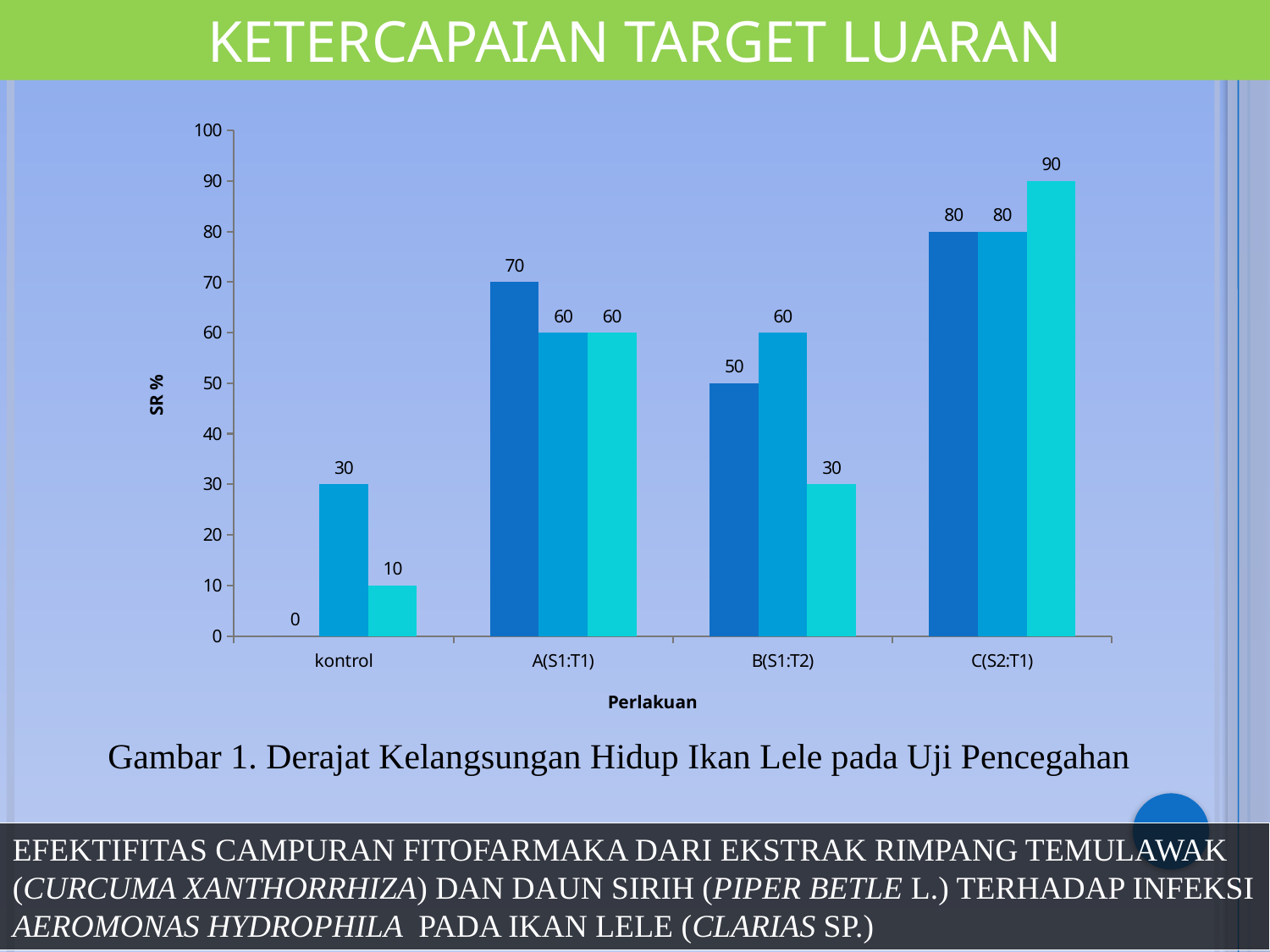
What is the difference between the cyan (third) bar for C(S2:T1) and the cyan (third) bar for B(S1:T2)? 60 What is the value of the cyan (third) bar for C(S2:T1)? 90 What is the value of the dark blue (first) bar for A(S1:T1)? 70 What type of chart is shown on the slide? bar chart What is the value of the medium blue (second) bar for B(S1:T2)? 60 What is the label of the y axis? SR % Which category has the lowest bar in the chart? kontrol Which category has the highest bar in the chart? C(S2:T1) What is the value of the cyan (third) bar for kontrol? 10 Which is larger: the dark blue (first) bar for A(S1:T1) or the dark blue (first) bar for B(S1:T2)? A(S1:T1) What is the label of the x axis? Perlakuan How many categories (perlakuan) are shown on the x axis? 4